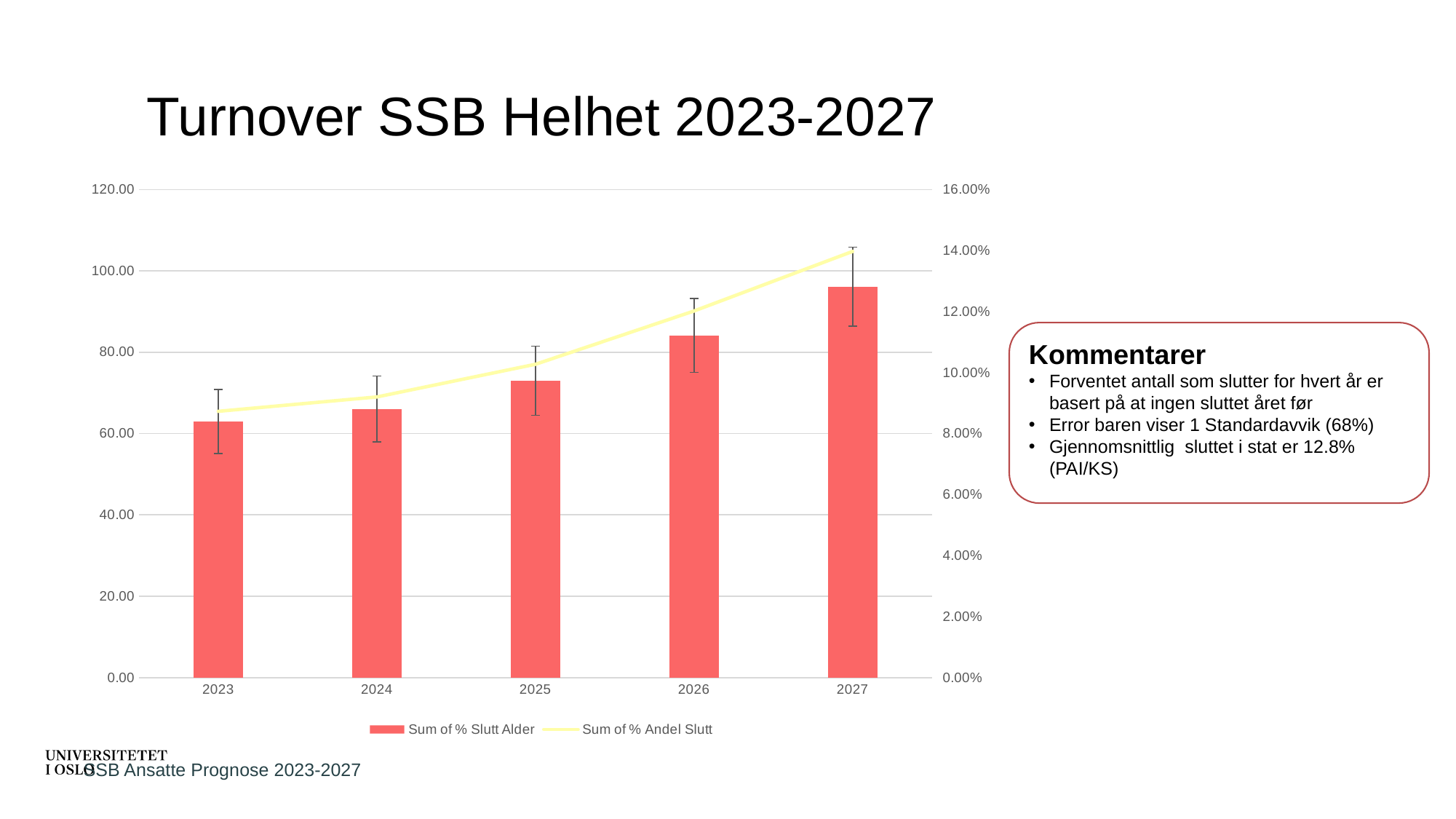
Which bar is taller, 2025 or 2026? 2026 What is the title of the chart on the slide? Turnover SSB Helhet 2023-2027 Do the Sum of % Slutt Alder bars rise or fall from 2023 to 2027? rise Is the bar for Sum of % Slutt Alder in 2026 greater or less than 80.00? greater Is the Sum of % Andel Slutt line value for 2023 greater or less than 10.00%? less Is the Sum of % Andel Slutt line value for 2027 greater or less than 12.00%? greater Which year has the shortest bar for Sum of % Slutt Alder? 2023 How many series does the chart legend list? 2 How many years are shown on the x axis of the chart? 5 What kind of chart is shown on the slide? A combined bar and line chart Which year has the tallest bar for Sum of % Slutt Alder? 2027